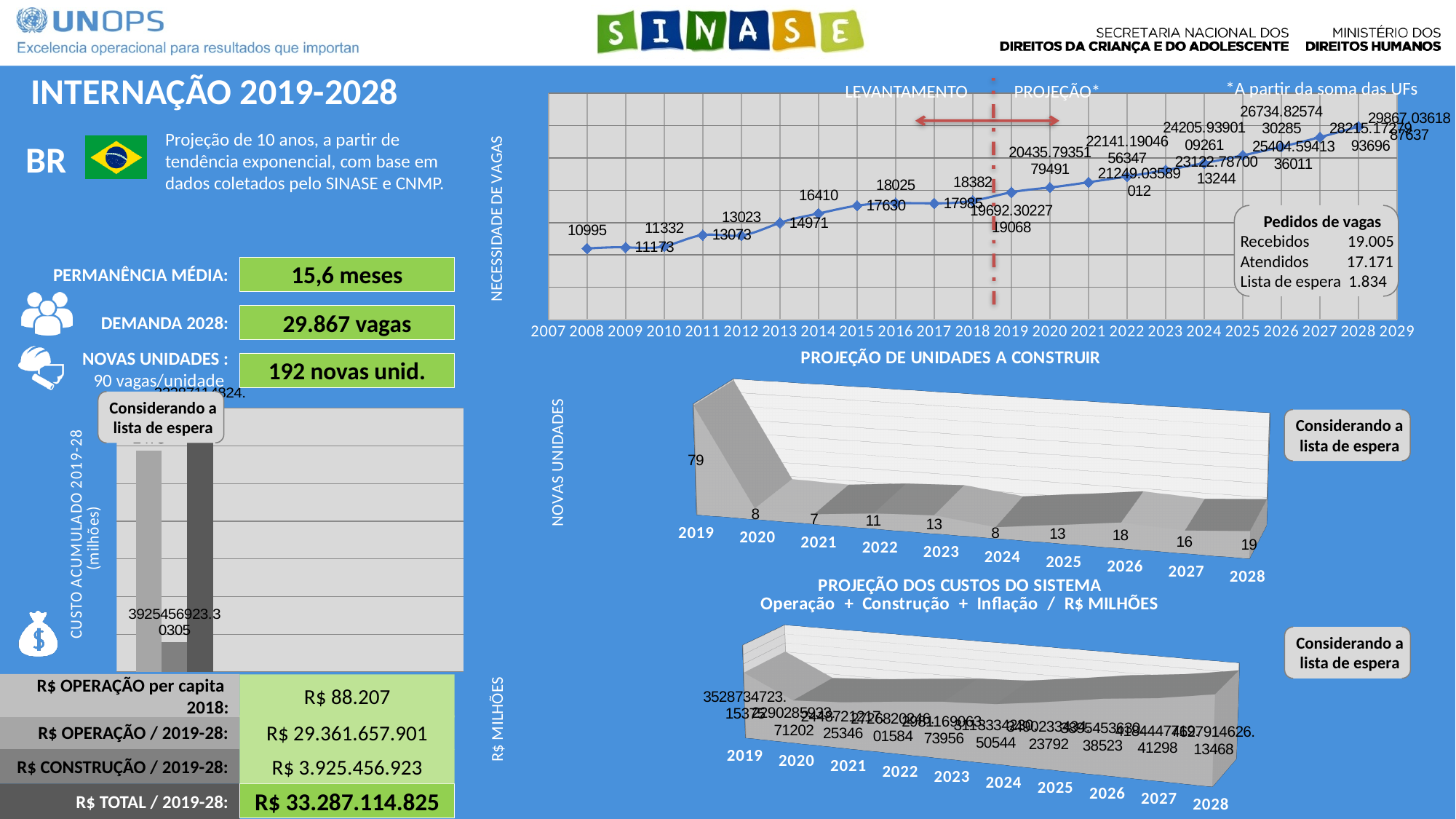
In the 'NECESSIDADE DE VAGAS' line chart at the top right, what is the value for 2008? 10995 In the 'PROJEÇÃO DE UNIDADES A CONSTRUIR' chart, what is the difference between the values for 2028 and 2027? 3 In the 'NECESSIDADE DE VAGAS' line chart at the top right, what is the value for 2014? 16410 In the 'PROJEÇÃO DE UNIDADES A CONSTRUIR' chart, how many new units are projected for 2028? 19 In the 'NECESSIDADE DE VAGAS' line chart at the top right, which year has the higher value, 2010 or 2013? 2013 In the 'PROJEÇÃO DE UNIDADES A CONSTRUIR' chart, which year has the highest number of new units? 2019 What kind of chart is the 'NECESSIDADE DE VAGAS' chart at the top right of the slide? line chart In the 'PROJEÇÃO DE UNIDADES A CONSTRUIR' chart, which year has the lowest number of new units? 2021 In the 'PROJEÇÃO DE UNIDADES A CONSTRUIR' chart, which year has more new units, 2025 or 2026? 2026 What kind of chart is the 'PROJEÇÃO DE UNIDADES A CONSTRUIR' chart? area chart How many years are shown on the x axis of the 'PROJEÇÃO DE UNIDADES A CONSTRUIR' chart? 10 In the 'PROJEÇÃO DE UNIDADES A CONSTRUIR' chart, how many new units are projected for 2019? 79